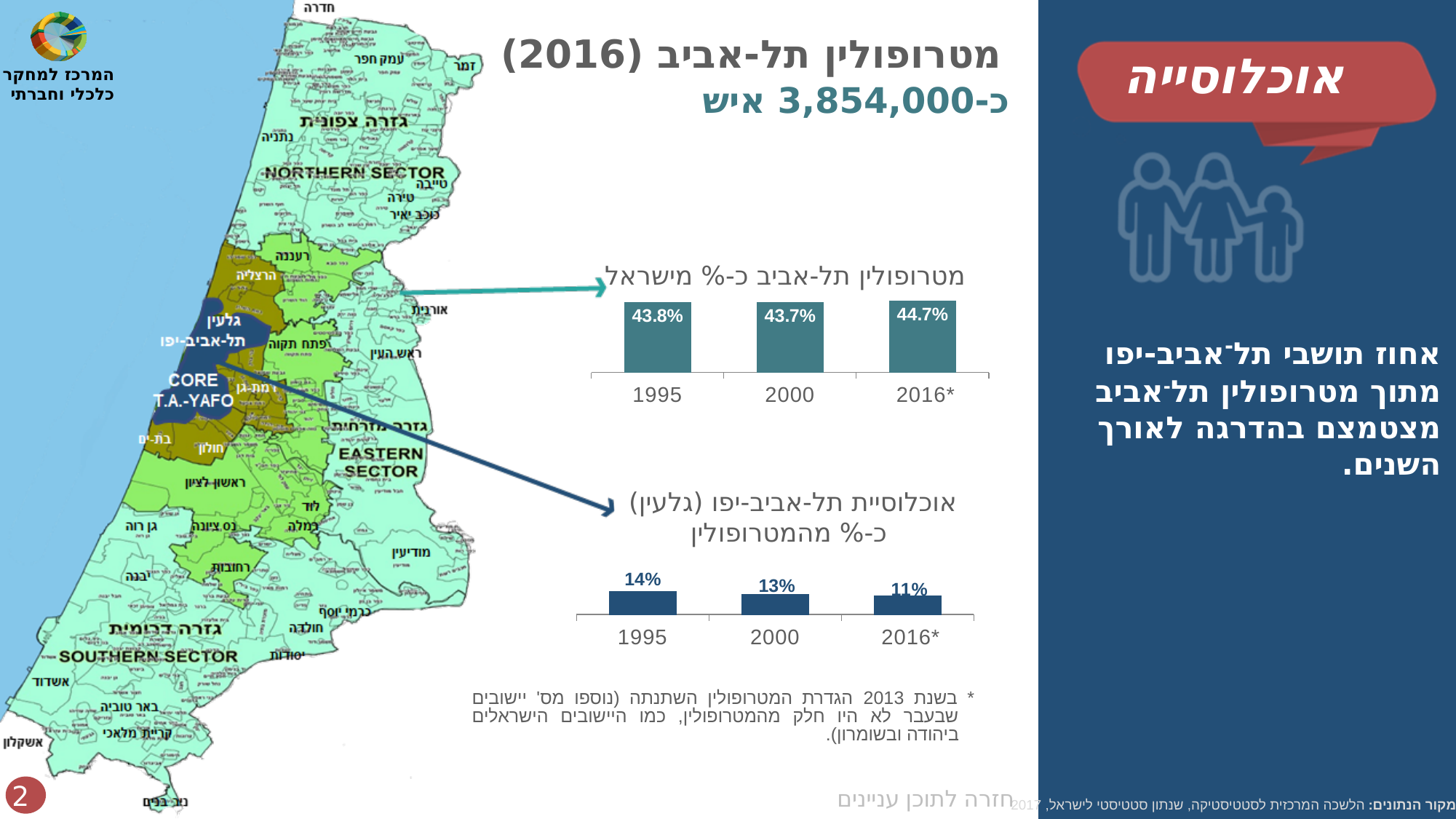
In the bottom chart (Tel Aviv-Yafo core as % of the metropolis), do the values rise or fall from 1995 to 2016*? fall In the top chart (Tel Aviv metropolis as % of Israel), which year has the lowest value? 2000 In the top chart (Tel Aviv metropolis as % of Israel), what is the value for 2016*? 44.7% In the top chart (Tel Aviv metropolis as % of Israel), what is the difference between the 2016* value and the 2000 value? 1.0% In the bottom chart (Tel Aviv-Yafo core as % of the metropolis), what is the value for 2016*? 11% In the bottom chart (Tel Aviv-Yafo core as % of the metropolis), what is the value for 2000? 13% In the top chart (Tel Aviv metropolis as % of Israel), is the value for 2016* larger or smaller than the value for 1995? larger How many bars are in the bottom chart (Tel Aviv-Yafo core as % of the metropolis)? 3 In the bottom chart (Tel Aviv-Yafo core as % of the metropolis), which year has the highest value? 1995 In the top chart (Tel Aviv metropolis as % of Israel), what is the value for 1995? 43.8% In the bottom chart (Tel Aviv-Yafo core as % of the metropolis), what is the difference between the 1995 value and the 2016* value? 3% What kind of chart is the top chart (Tel Aviv metropolis as % of Israel)? bar chart